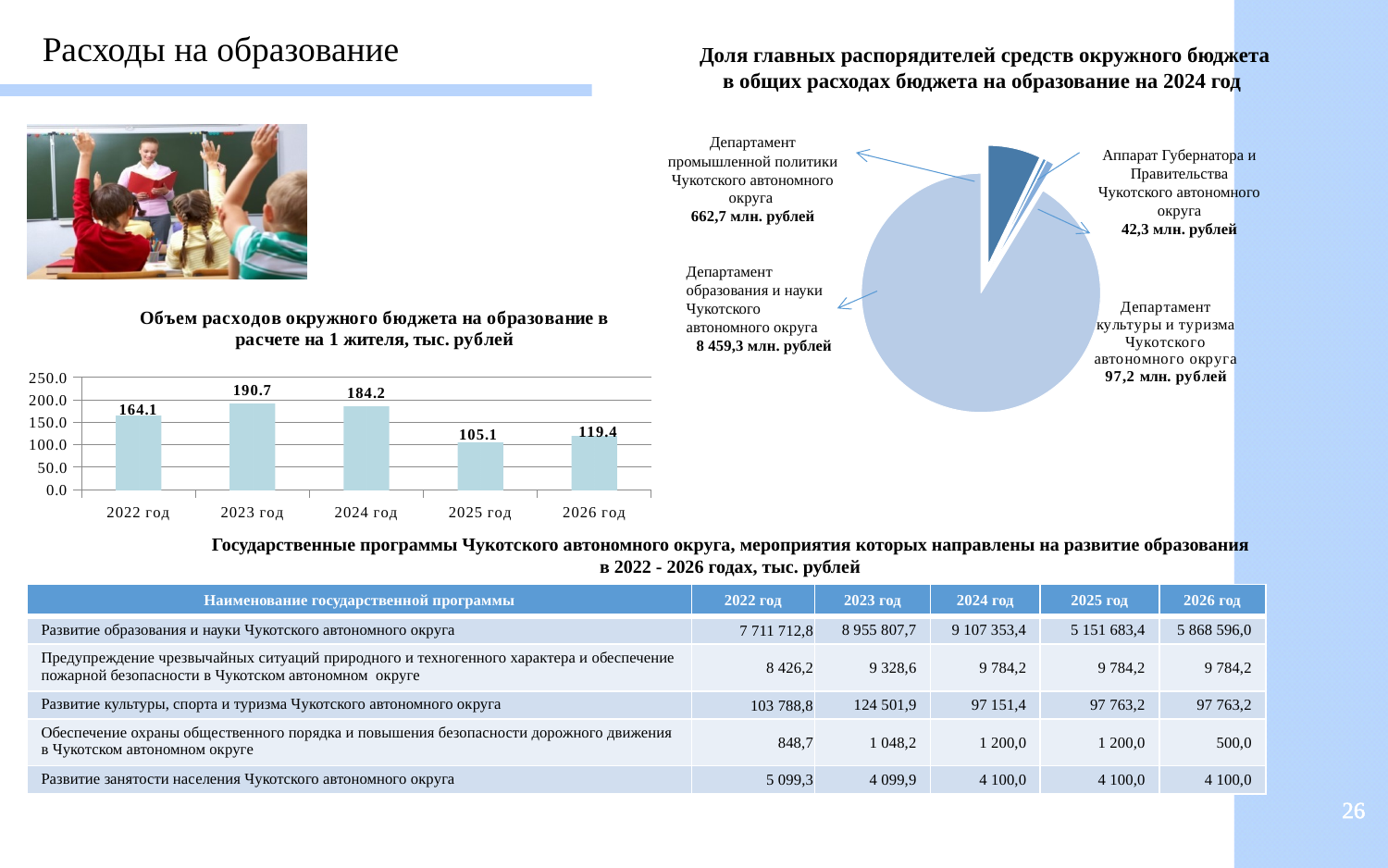
What type of chart is 'Доля главных распорядителей средств окружного бюджета в общих расходах бюджета на образование на 2024 год'? pie chart In the bar chart 'Объем расходов окружного бюджета на образование в расчете на 1 жителя, тыс. рублей', which is larger: the value for 2024 год or 2026 год? 2024 год In the bar chart 'Объем расходов окружного бюджета на образование в расчете на 1 жителя, тыс. рублей', what is the value for 2025 год? 105.1 In the bar chart 'Объем расходов окружного бюджета на образование в расчете на 1 жителя, тыс. рублей', what is the value for 2023 год? 190.7 In the pie chart 'Доля главных распорядителей средств окружного бюджета в общих расходах бюджета на образование на 2024 год', what is the value for Аппарат Губернатора и Правительства Чукотского автономного округа? 42,3 млн. рублей In the bar chart 'Объем расходов окружного бюджета на образование в расчете на 1 жителя, тыс. рублей', what is the difference between the values for 2023 год and 2022 год? 26.6 In the bar chart 'Объем расходов окружного бюджета на образование в расчете на 1 жителя, тыс. рублей', how many years are shown? 5 In the bar chart 'Объем расходов окружного бюджета на образование в расчете на 1 жителя, тыс. рублей', which year has the highest value? 2023 год What type of chart is 'Объем расходов окружного бюджета на образование в расчете на 1 жителя, тыс. рублей'? bar chart In the pie chart 'Доля главных распорядителей средств окружного бюджета в общих расходах бюджета на образование на 2024 год', which category has the smallest slice? Аппарат Губернатора и Правительства Чукотского автономного округа In the bar chart 'Объем расходов окружного бюджета на образование в расчете на 1 жителя, тыс. рублей', which year has the lowest value? 2025 год In the pie chart 'Доля главных распорядителей средств окружного бюджета в общих расходах бюджета на образование на 2024 год', what is the value for Департамент образования и науки Чукотского автономного округа? 8 459,3 млн. рублей